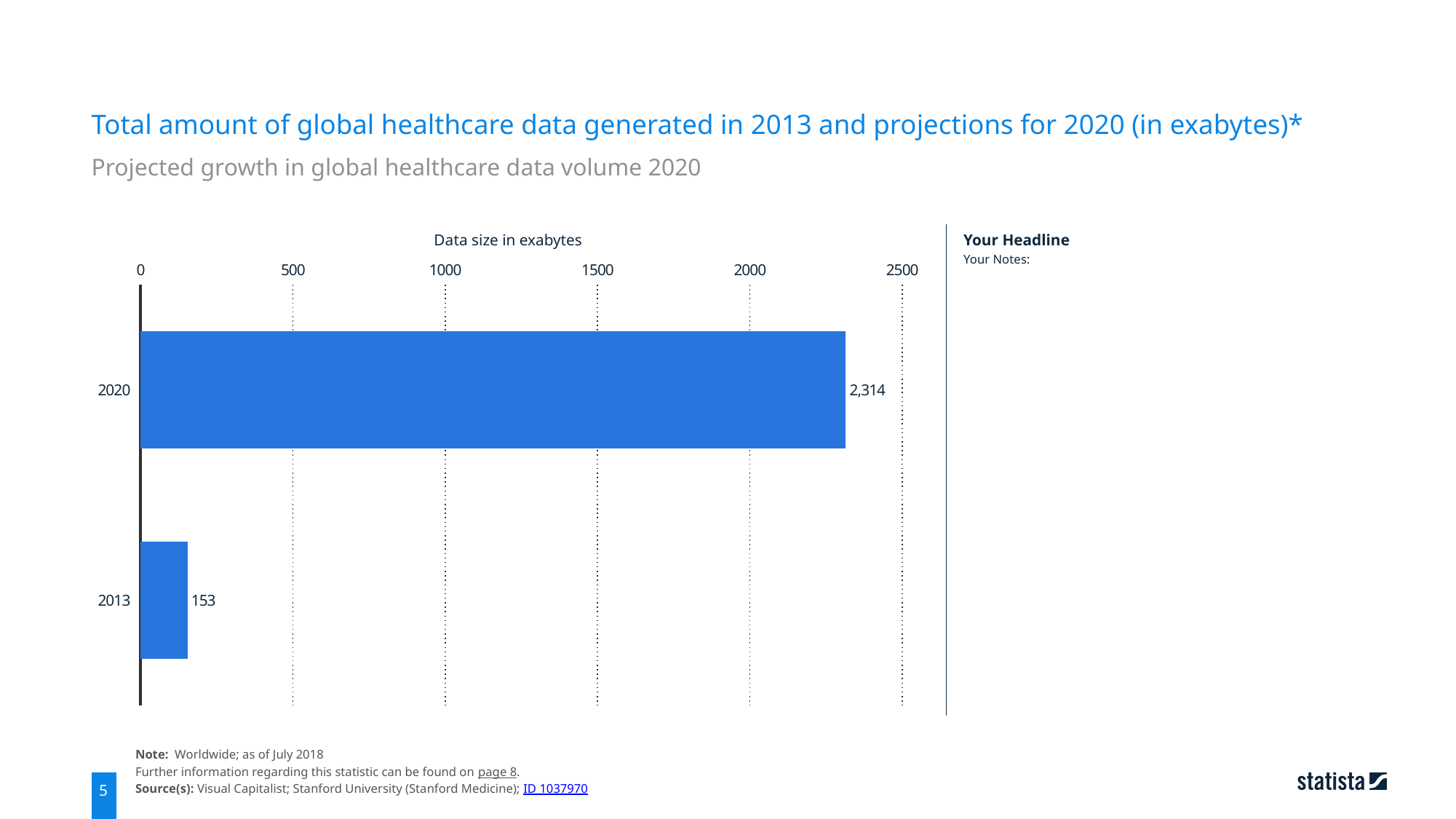
Is the value for 2020 greater or less than 2000? greater Which is larger, the value for 2020 or the value for 2013? 2020 What is the axis label shown above the chart? Data size in exabytes Which year has the highest data size? 2020 How many years are shown in the chart? 2 What kind of chart is shown on the slide? bar chart Is the value for 2013 greater or less than 500? less What is the difference in exabytes between the 2020 and 2013 values? 2,161 What is the highest value shown on the horizontal axis? 2500 Which year has the lowest data size? 2013 What is the data size in exabytes for 2020? 2,314 What is the data size in exabytes for 2013? 153